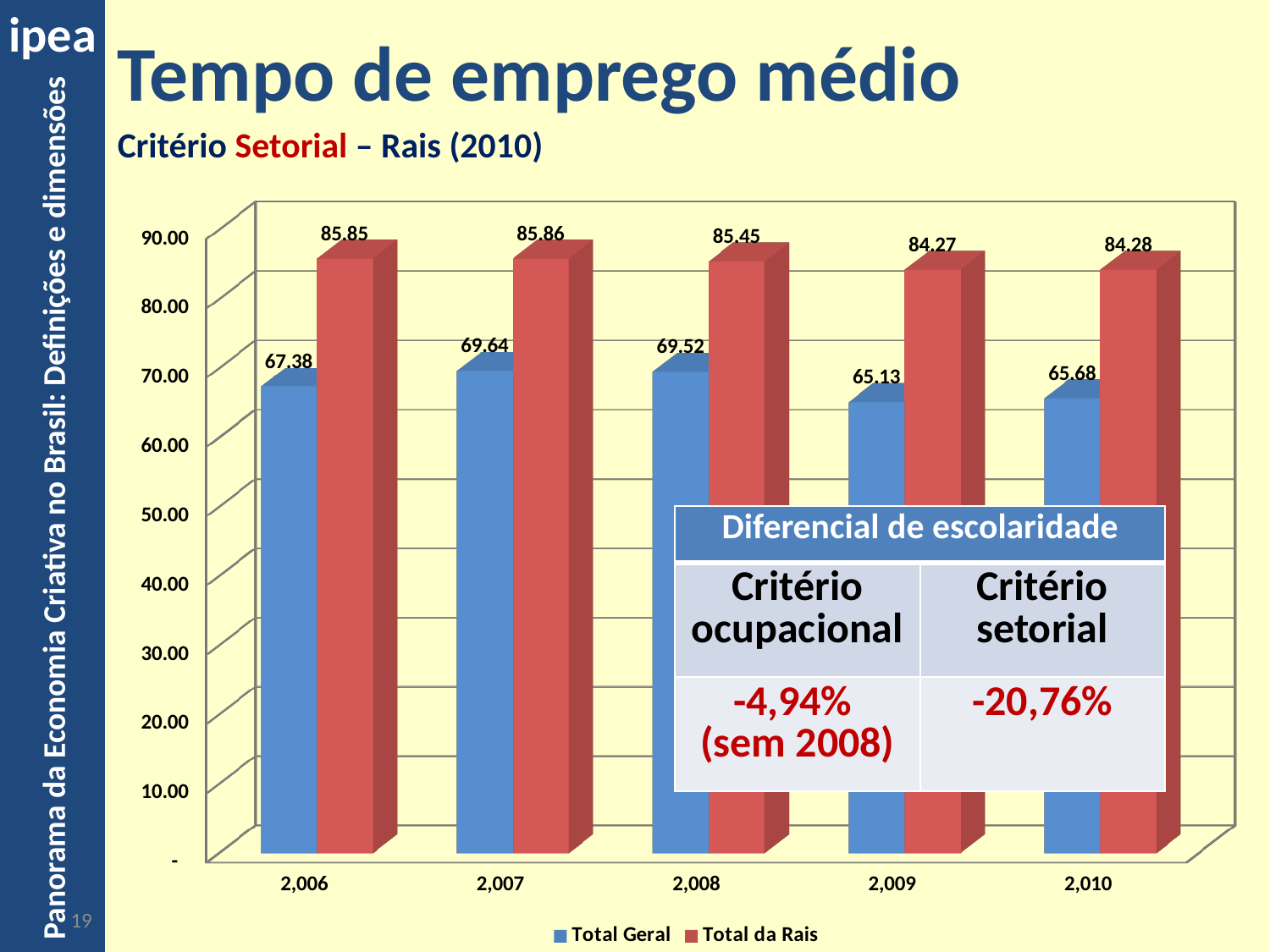
What kind of chart is shown on the slide? Bar chart What is the value of Total Geral for 2,006? 67.38 What is the value of Total Geral for 2,010? 65.68 Which is larger, Total Geral in 2,009 or Total Geral in 2,010? Total Geral in 2,010 In which year is the Total Geral value lowest? 2,009 Is the value for Total da Rais in 2,008 greater or less than 80.00? greater How many years are shown on the x axis? 5 How many series does the legend list? 2 In which year is the Total Geral value highest? 2,007 What are the two series named in the legend? Total Geral and Total da Rais What is the value of Total da Rais for 2,009? 84.27 What is the difference between Total da Rais and Total Geral in 2,006? 18.47